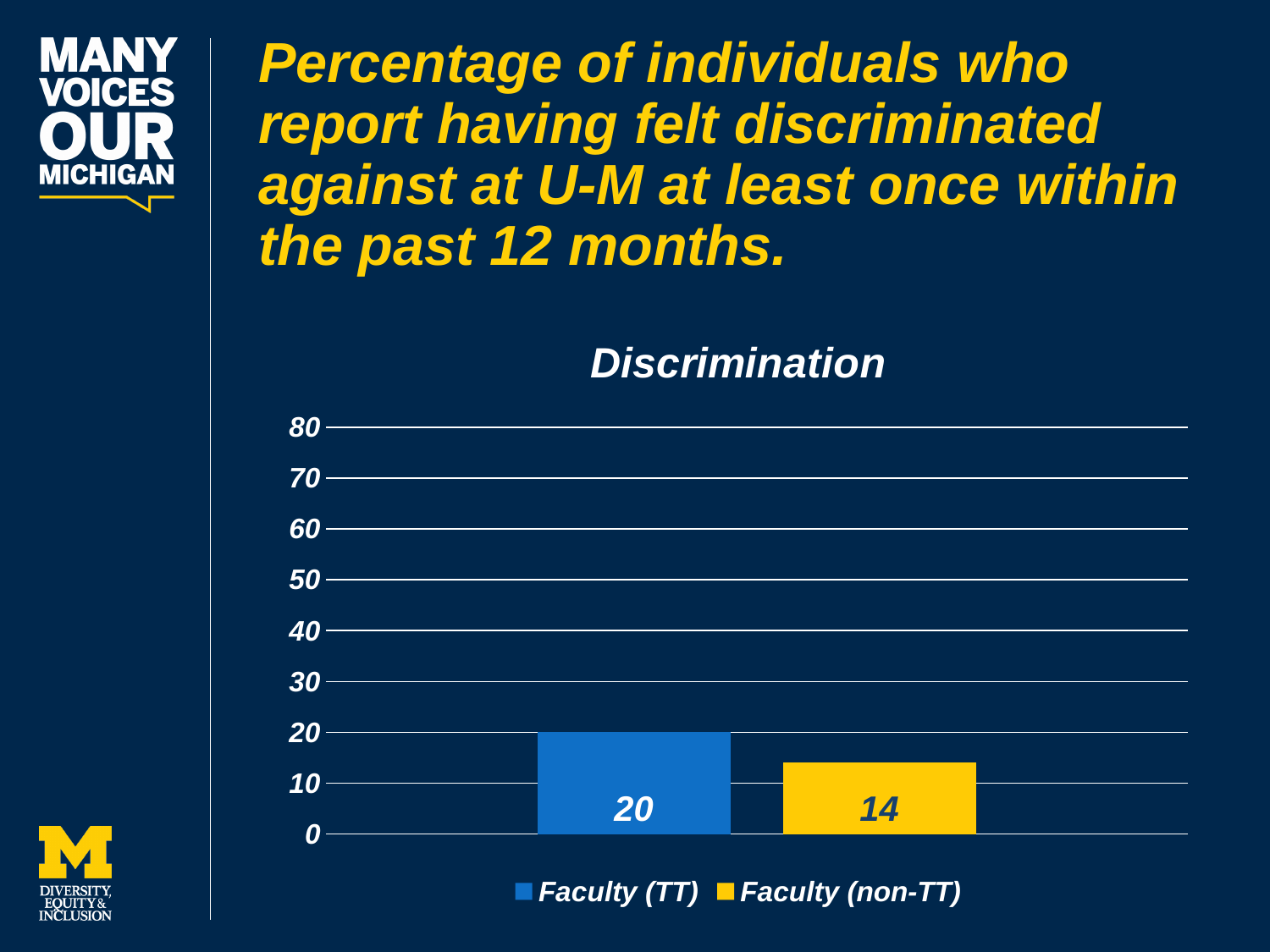
What is the value for Faculty (TT) in the Discrimination chart? 20 Is the value for Faculty (non-TT) greater or less than 20? less Is the value for Faculty (TT) greater or less than 30? less What is the title of the chart? Discrimination What is the difference between the Faculty (TT) and Faculty (non-TT) values? 6 What is the value for Faculty (non-TT) in the Discrimination chart? 14 Is the value for Faculty (TT) larger or smaller than the value for Faculty (non-TT)? larger What kind of chart is shown on the slide? bar chart Which series has the higher value in the Discrimination chart? Faculty (TT) How many bars are plotted in the chart? 2 Which series has the lower value in the Discrimination chart? Faculty (non-TT) How many series does the legend list? 2